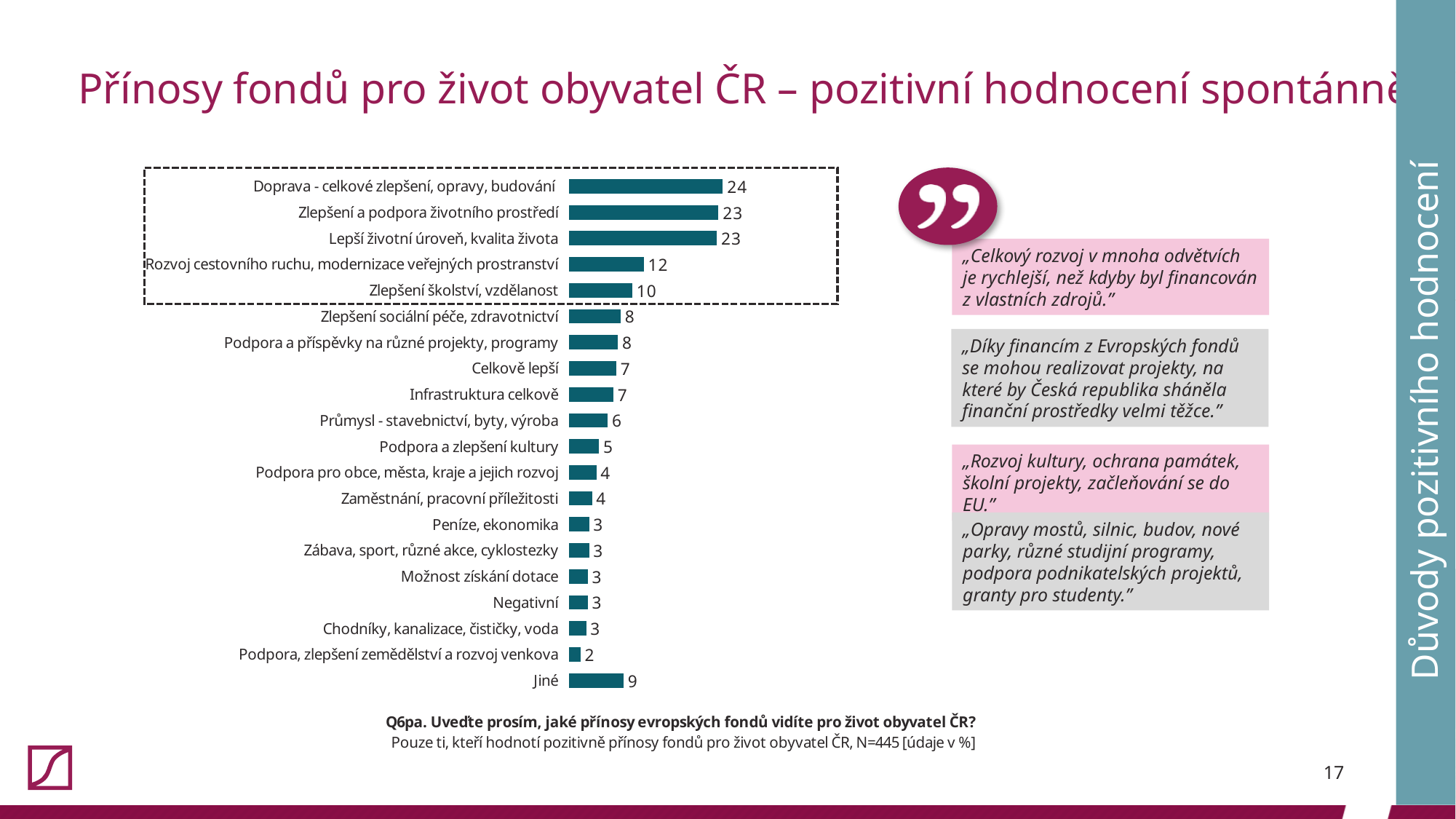
How many categories are enclosed in the dashed box at the top of the chart? 5 What is the difference between the values for "Doprava - celkové zlepšení, opravy, budování" and "Zlepšení školství, vzdělanost"? 14 Which is larger: the value for "Průmysl - stavebnictví, byty, výroba" or the value for "Podpora a zlepšení kultury"? Průmysl - stavebnictví, byty, výroba What value is shown for "Jiné"? 9 Which category has the lowest value in the chart? Podpora, zlepšení zemědělství a rozvoj venkova What kind of chart is shown on the slide? Bar chart Which category has the highest value in the chart? Doprava - celkové zlepšení, opravy, budování What value is shown for "Zlepšení školství, vzdělanost"? 10 What value is shown for "Rozvoj cestovního ruchu, modernizace veřejných prostranství"? 12 What value is shown for "Doprava - celkové zlepšení, opravy, budování"? 24 How many categories are shown in the chart? 20 What is the difference between the values for "Rozvoj cestovního ruchu, modernizace veřejných prostranství" and "Jiné"? 3